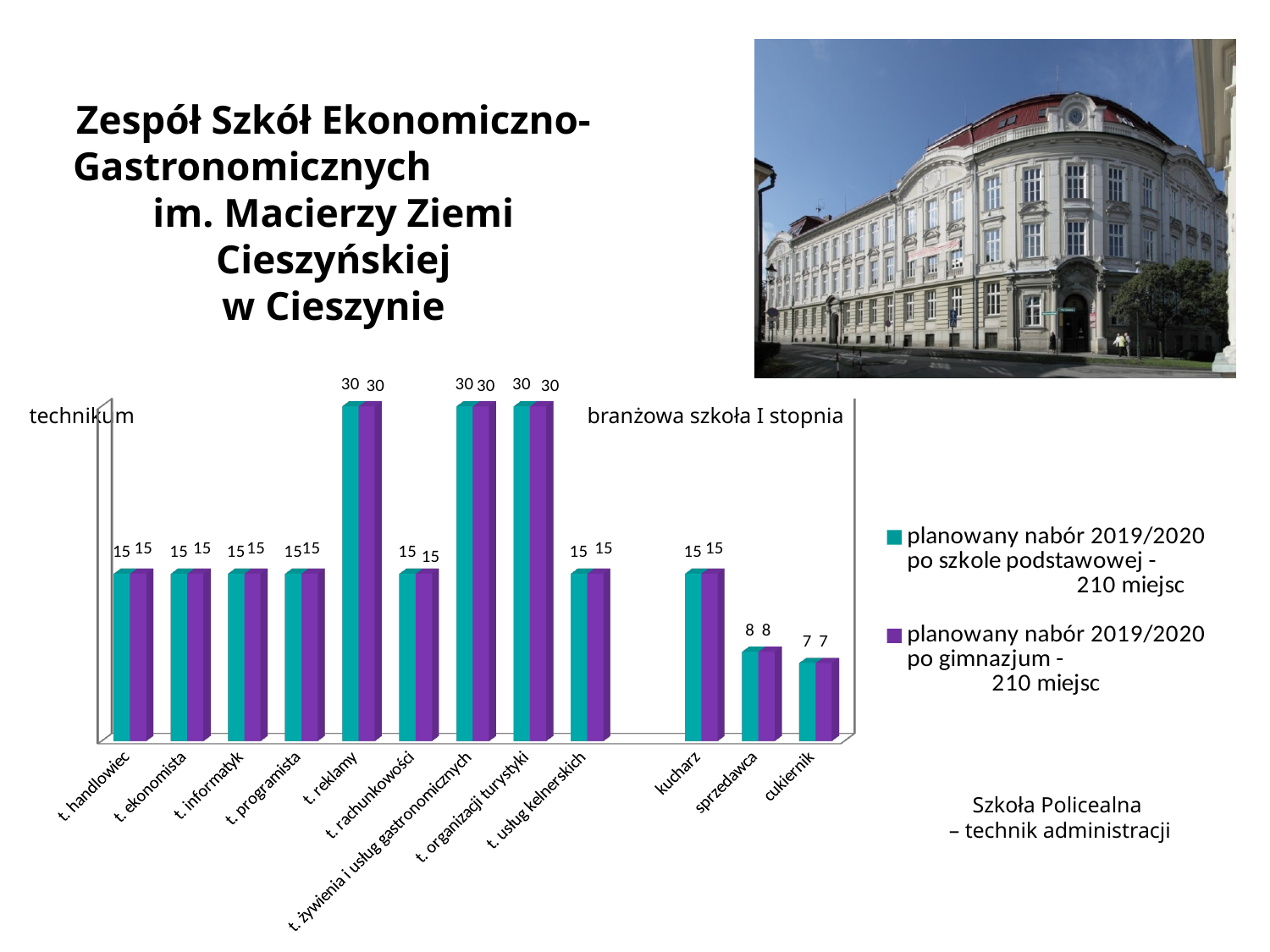
What kind of chart is shown on the slide? bar chart How many series does the chart legend list? 2 Which is larger: the planned intake after gimnazjum for kucharz or for sprzedawca? kucharz What is the planned intake after primary school (po szkole podstawowej) for sprzedawca? 8 How many categories are shown on the x axis of the chart? 12 What is the planned intake after gimnazjum for cukiernik? 7 What is the difference between the planned intake after primary school for t. organizacji turystyki and for t. usług kelnerskich? 15 What is the planned intake after primary school (po szkole podstawowej) for t. reklamy? 30 What is the planned intake after gimnazjum for t. handlowiec? 15 What is the difference between the planned intake after gimnazjum for sprzedawca and for cukiernik? 1 Which category has the lowest planned intake after primary school? cukiernik According to the legend, how many places in total are planned for the intake after primary school in 2019/2020? 210 miejsc